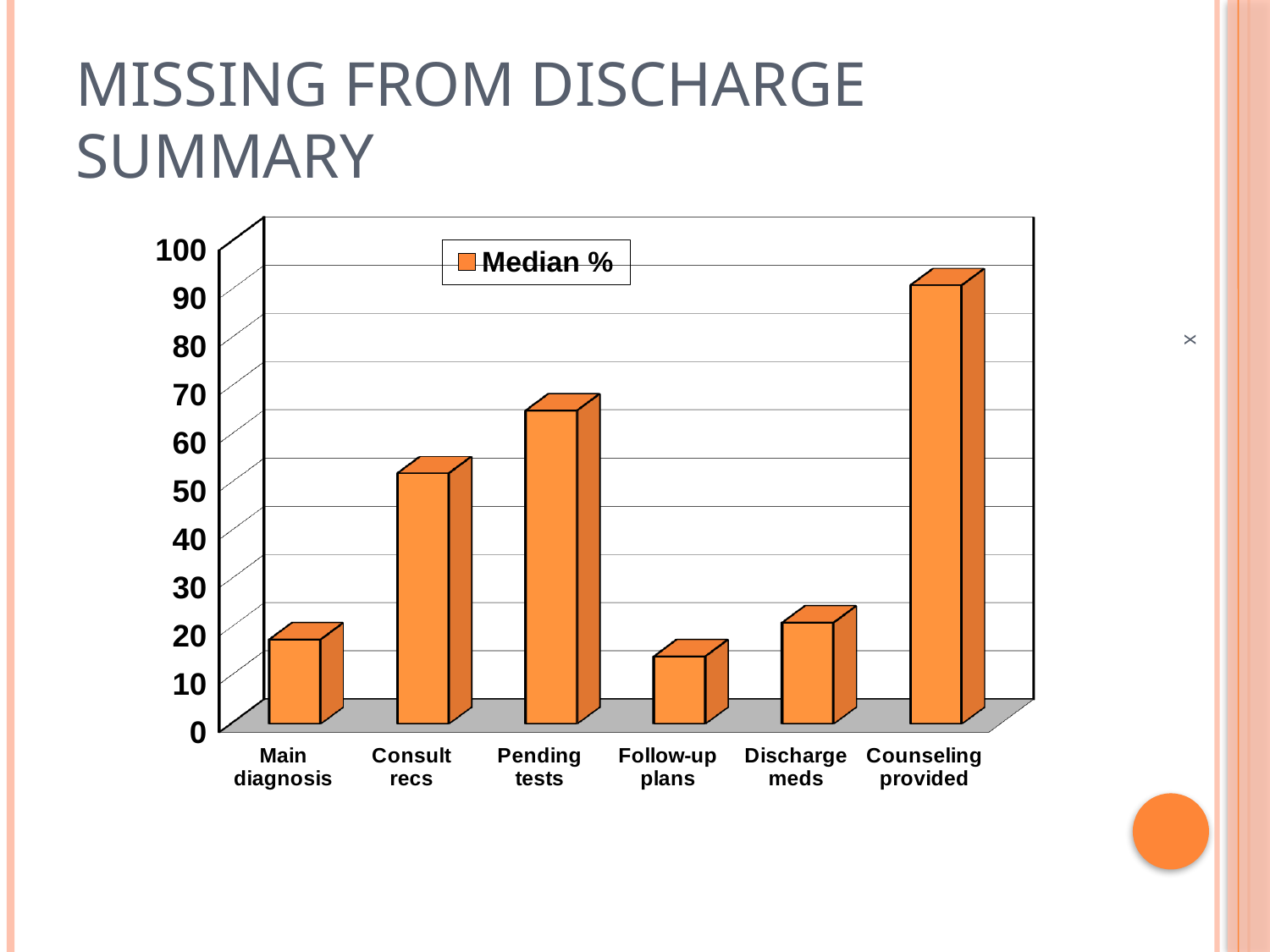
How many categories are shown on the x axis of the chart? 6 Is the Median % for Pending tests greater or less than 60? greater Which has a higher Median %, Pending tests or Consult recs? Pending tests Which category has the lowest Median %? Follow-up plans Is the Median % for Counseling provided greater or less than 80? greater Is the Median % for Consult recs greater or less than 60? less What kind of chart is shown on the slide? bar chart What is the name of the series shown in the legend? Median % Which has a higher Median %, Discharge meds or Main diagnosis? Discharge meds Which category has the highest Median %? Counseling provided How many series does the legend list? 1